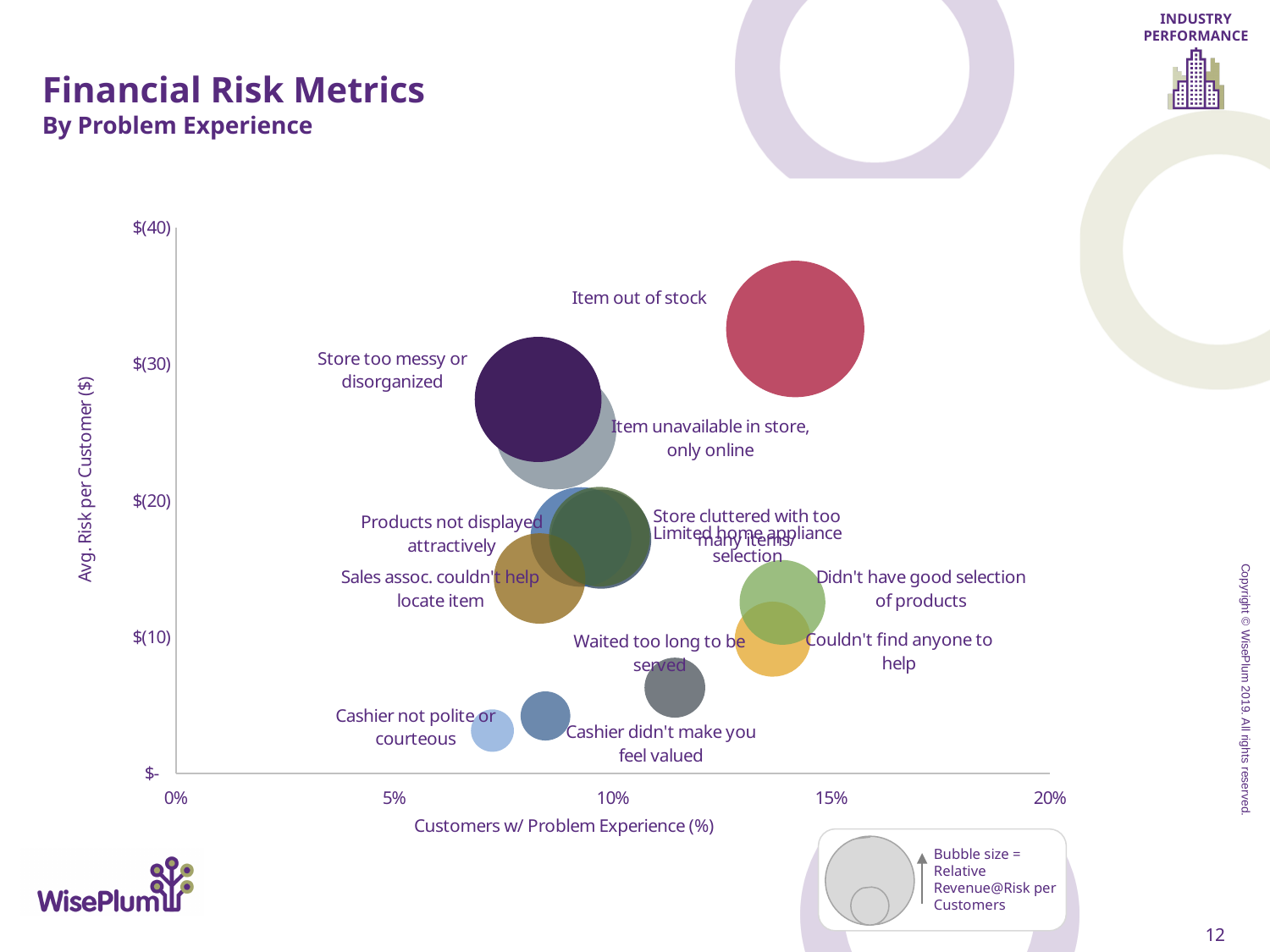
Which has a larger share of customers with the problem experience: 'Didn't have good selection of products' or 'Sales assoc. couldn't help locate item'? Didn't have good selection of products What does the bubble size represent in the chart? Relative Revenue@Risk per Customers Which problem experience has the lowest average risk per customer? Cashier not polite or courteous What kind of chart is shown on the slide? Bubble chart How many problem experiences are labeled in the chart? 12 Which problem experience has the highest average risk per customer? Item out of stock Is the share of customers with the 'Item out of stock' problem experience greater or less than 10%? greater Is the average risk per customer for 'Item out of stock' greater or less than $(30)? greater Which has a higher average risk per customer: 'Store too messy or disorganized' or 'Waited too long to be served'? Store too messy or disorganized What is the title of the chart on the slide? Financial Risk Metrics By Problem Experience Is the average risk per customer for 'Cashier didn't make you feel valued' greater or less than $(10)? less